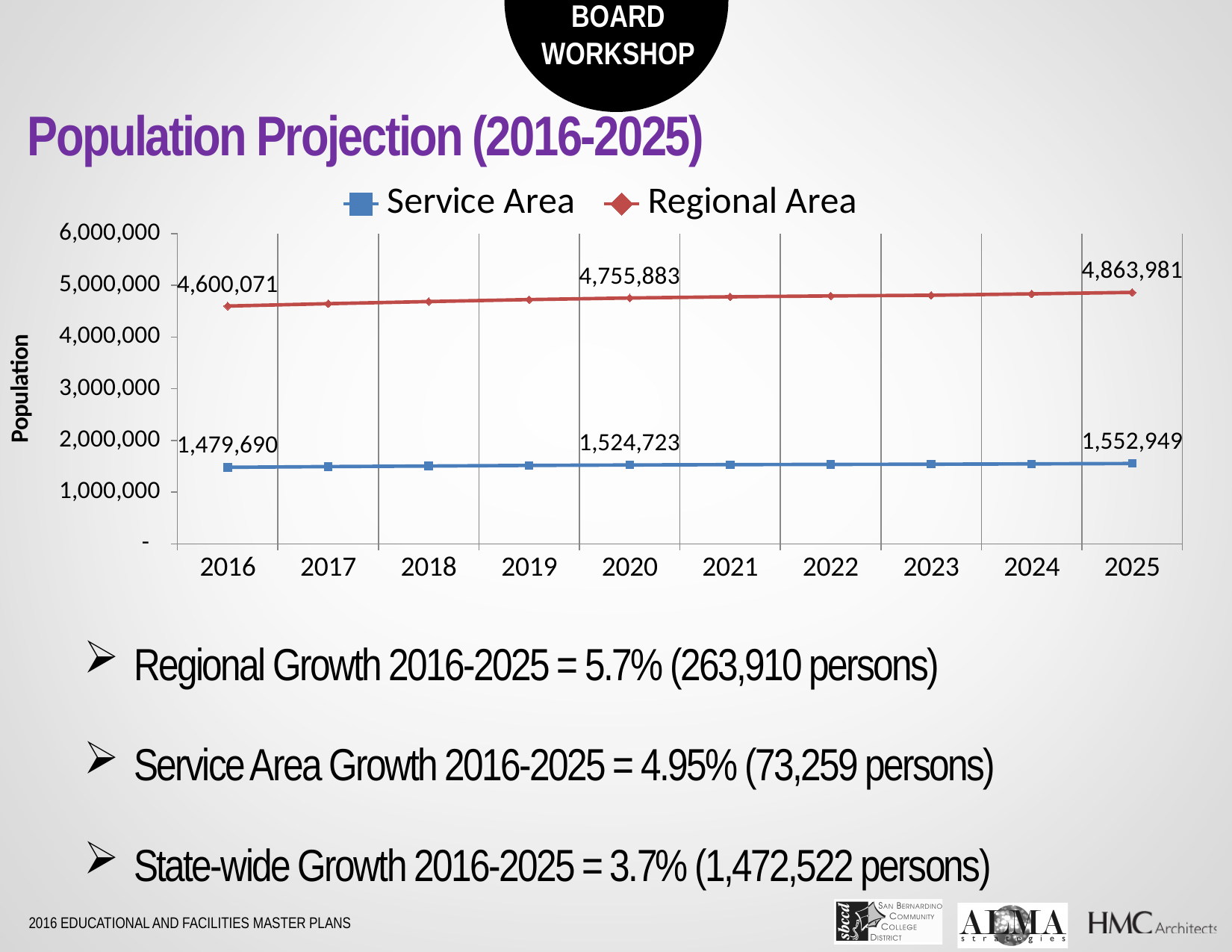
Does the Regional Area line rise or fall from 2016 to 2025? Rise Is the Service Area value for 2022 greater or less than 2,000,000? less What is the Service Area population value shown for 2020? 1,524,723 What is the Service Area population value shown for 2025? 1,552,949 What is the difference between the Regional Area values for 2025 and 2016? 263,910 What type of chart is shown on the slide? Line chart What is the Regional Area population value shown for 2020? 4,755,883 How many series does the legend list? 2 Which series has the higher value in 2025, Service Area or Regional Area? Regional Area What is the difference between the Regional Area and Service Area values in 2020? 3,231,160 What is the Regional Area population value shown for 2016? 4,600,071 How many years are plotted along the x axis? 10